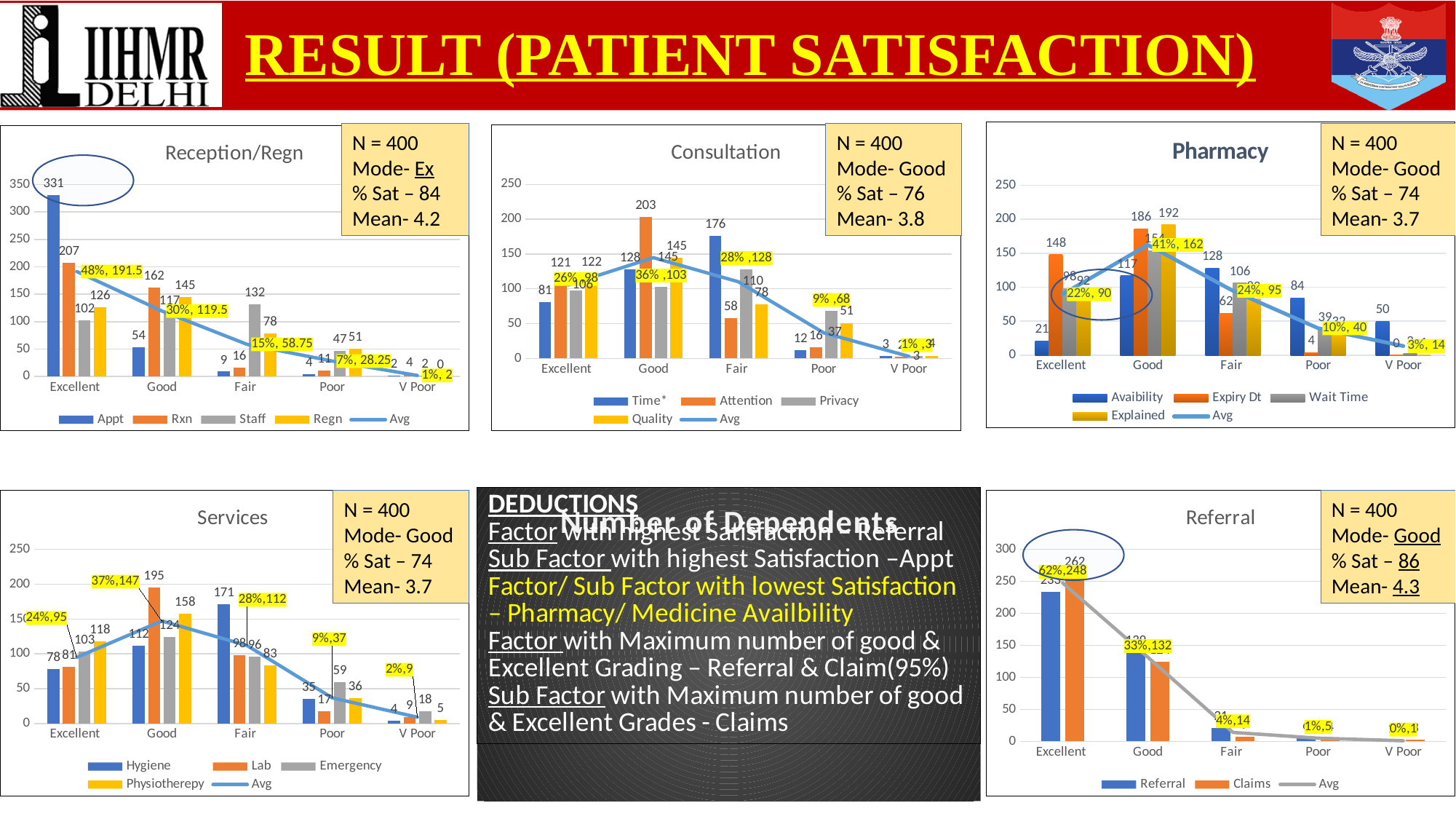
In the Referral chart, how many series does the legend list? 3 In the Pharmacy chart, what is the difference between Explained and Avaibility in the Good category? 75 In the Consultation chart, which category has the highest value for Time*? Fair In the Pharmacy chart, what is the value for Expiry Dt in the Excellent category? 148 In the Reception/Regn chart, how many series does the legend list? 5 In the Referral chart, is the value for Claims in the Excellent category greater or less than 250? greater In the Reception/Regn chart, what is the value for Appt in the Excellent category? 331 In the Services chart, how many categories are shown on the x axis? 5 In the Reception/Regn chart, what is the value for Staff in the Fair category? 132 In the Consultation chart, what is the value for Attention in the Good category? 203 In the Services chart, which is larger in the Fair category, Hygiene or Physiotherepy? Hygiene In the Services chart, what is the value for Lab in the Good category? 195